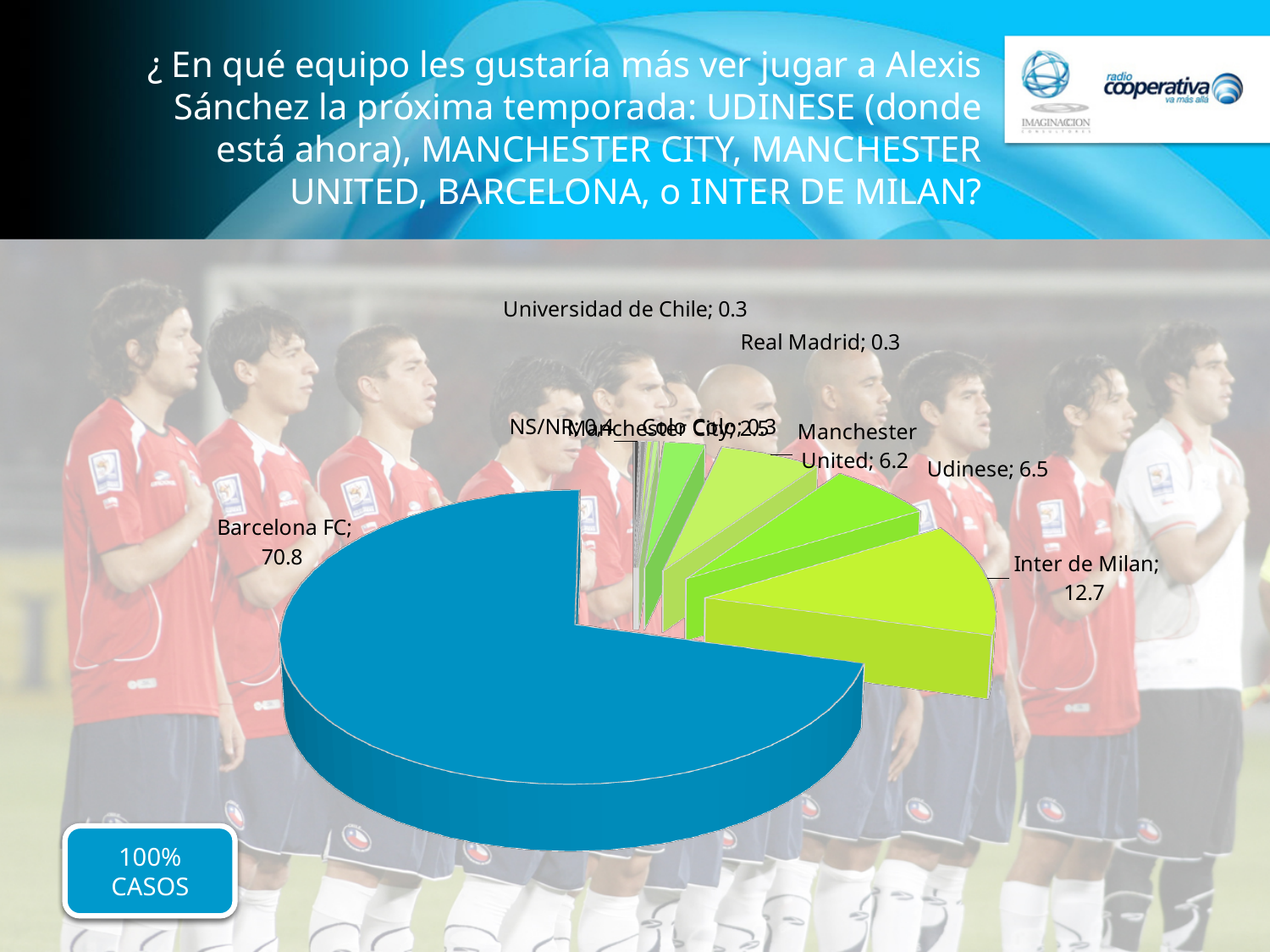
What is the difference between the values for Inter de Milan and Udinese? 6.2 What value is shown for Inter de Milan in the pie chart? 12.7 What value is shown for Barcelona FC in the pie chart? 70.8 What kind of chart is shown on the slide? Pie chart What value is shown for Manchester United in the pie chart? 6.2 What value is shown for Udinese in the pie chart? 6.5 What colour is the Barcelona FC slice of the pie chart? Blue Which is larger, the value for Udinese or the value for Manchester United? Udinese What is the difference between the values for Barcelona FC and Inter de Milan? 58.1 What value is shown for Universidad de Chile in the pie chart? 0.3 Which team has the largest slice of the pie chart? Barcelona FC What value is shown for Real Madrid in the pie chart? 0.3